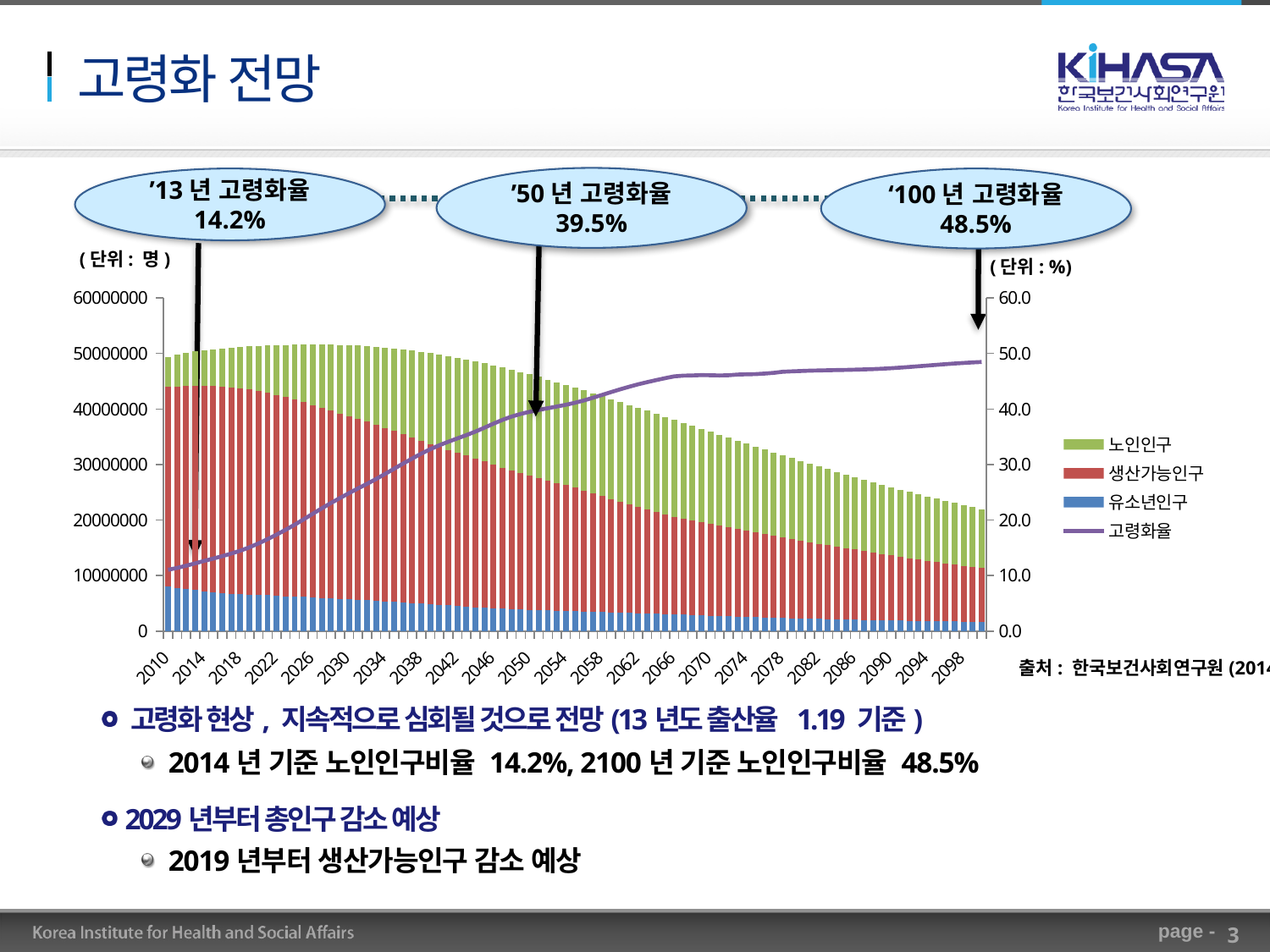
Is the total stacked bar value for 2098 greater or less than 30000000? less What kind of chart is shown on the slide? A stacked bar chart combined with a line chart What is the difference between the 고령화율 for '100년 and for '13년 shown in the callouts? 34.3 percentage points Does the 고령화율 line rise or fall from 2010 to 2098? Rise Which is larger, the 고령화율 for '50년 or for '13년? '50년 According to the callout, what is the 고령화율 for '100년? 48.5% How many series does the chart legend list? 4 According to the callout, what is the 고령화율 for '13년? 14.2% What unit is shown for the left vertical axis? 명 According to the callout, what is the 고령화율 for '50년? 39.5% Which series has the largest segment in the 2010 bar? 생산가능인구 Is the total stacked bar value for 2010 greater or less than 40000000? greater